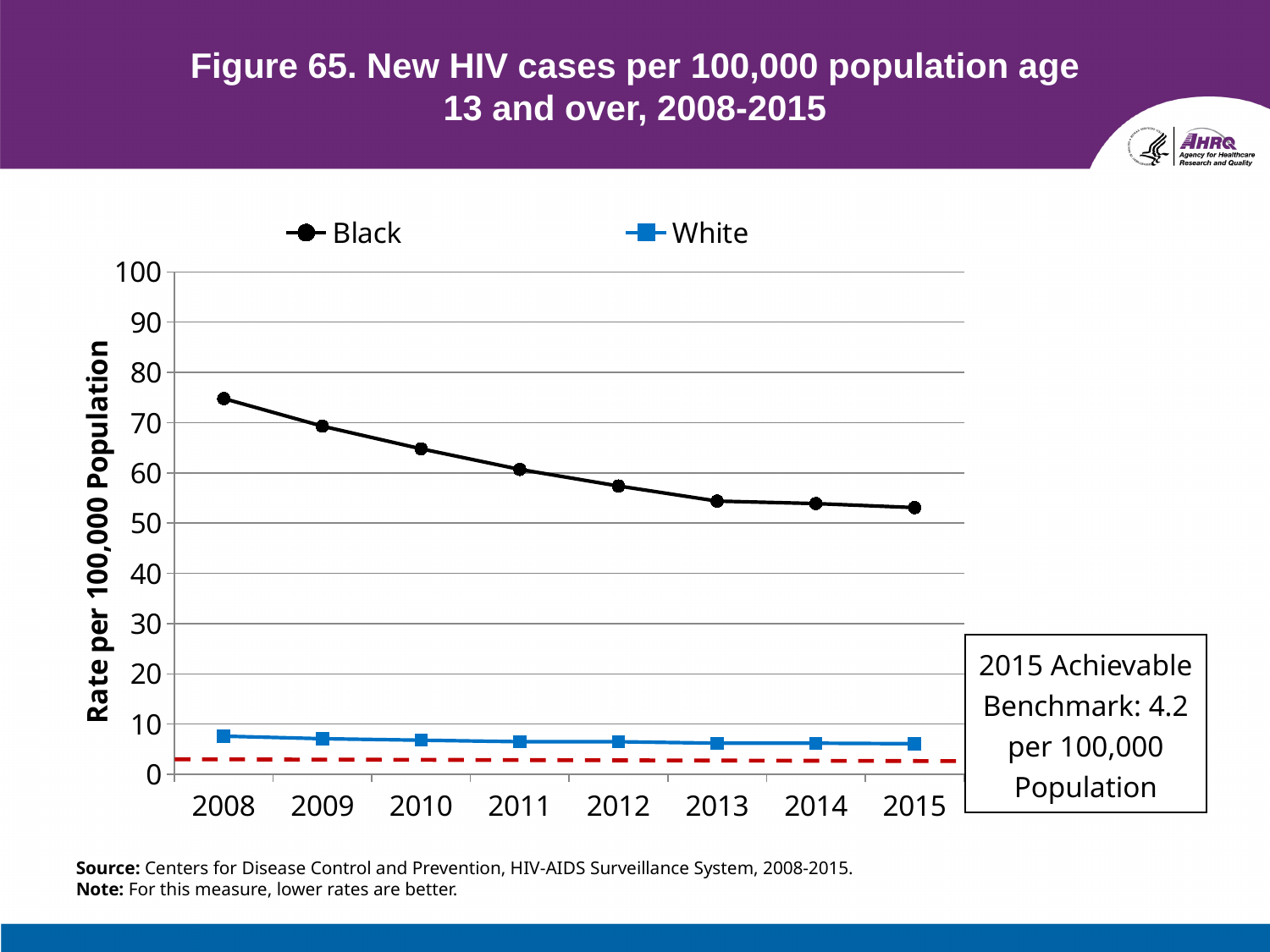
How many series does the legend list? 2 How many years are plotted along the x axis? 8 What is the label of the y axis? Rate per 100,000 Population Is the value for White in 2008 greater or less than 10? less What kind of chart is shown on the slide? line chart In which year is the rate for Black highest? 2008 What is the 2015 Achievable Benchmark shown on the chart? 4.2 per 100,000 Population Does the rate for Black rise or fall from 2008 to 2015? fall Is the value for Black in 2008 greater or less than 70? greater Is the value for Black in 2010 greater or less than 60? greater Which series has the higher rate in 2012, Black or White? Black